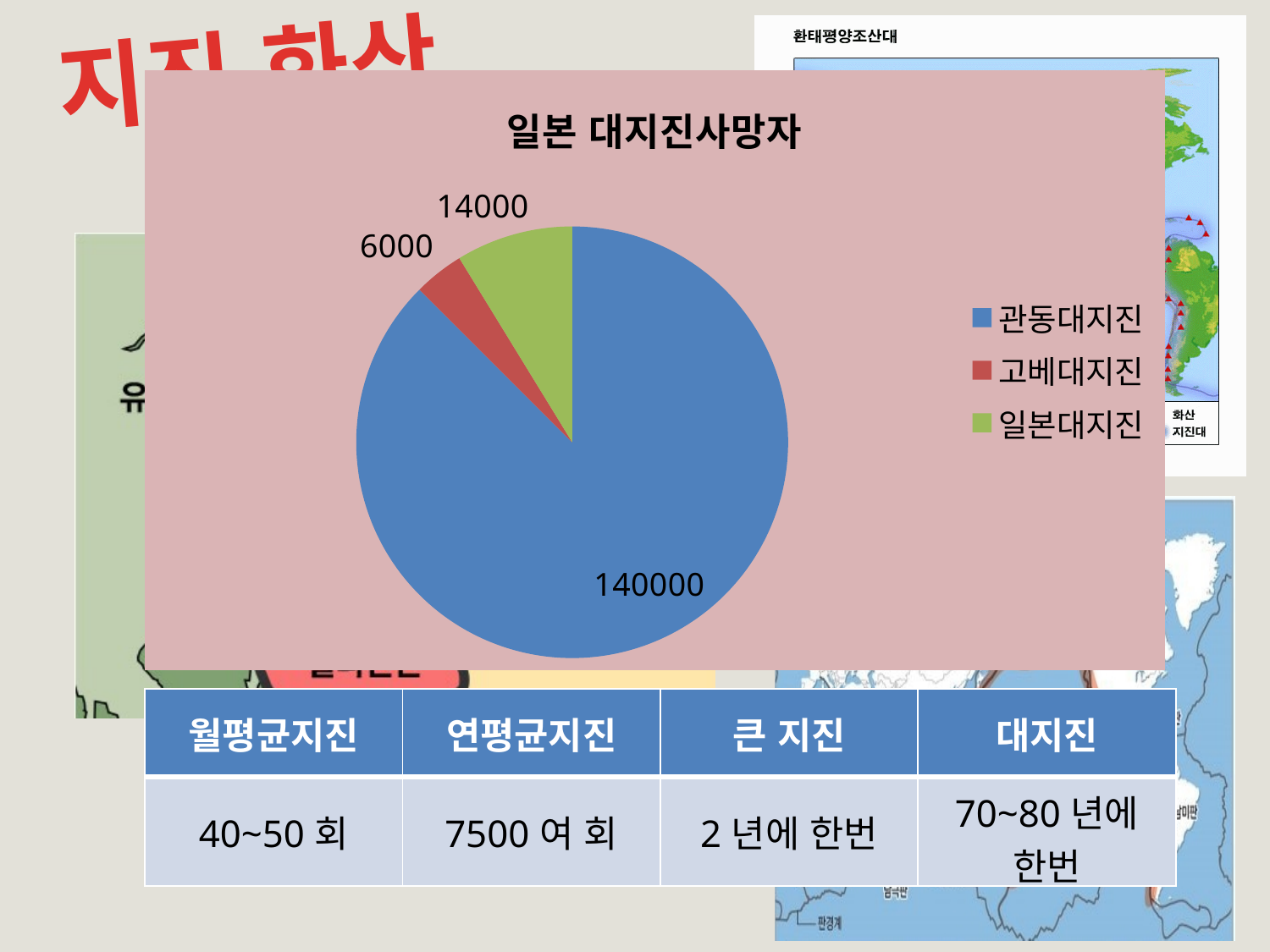
How many entries does the legend list? 3 What type of chart is shown on the slide? pie chart Which is larger, the value for 일본대지진 or the value for 고베대지진? 일본대지진 What share of the pie does 관동대지진 represent? 87.5% How many slices does the pie chart have? 3 What is the value for 관동대지진? 140000 What is the value for 일본대지진? 14000 What is the difference between the values for 관동대지진 and 일본대지진? 126000 What is the title of the chart? 일본 대지진사망자 Which category has the largest slice? 관동대지진 Which category has the smallest slice? 고베대지진 What is the value for 고베대지진? 6000